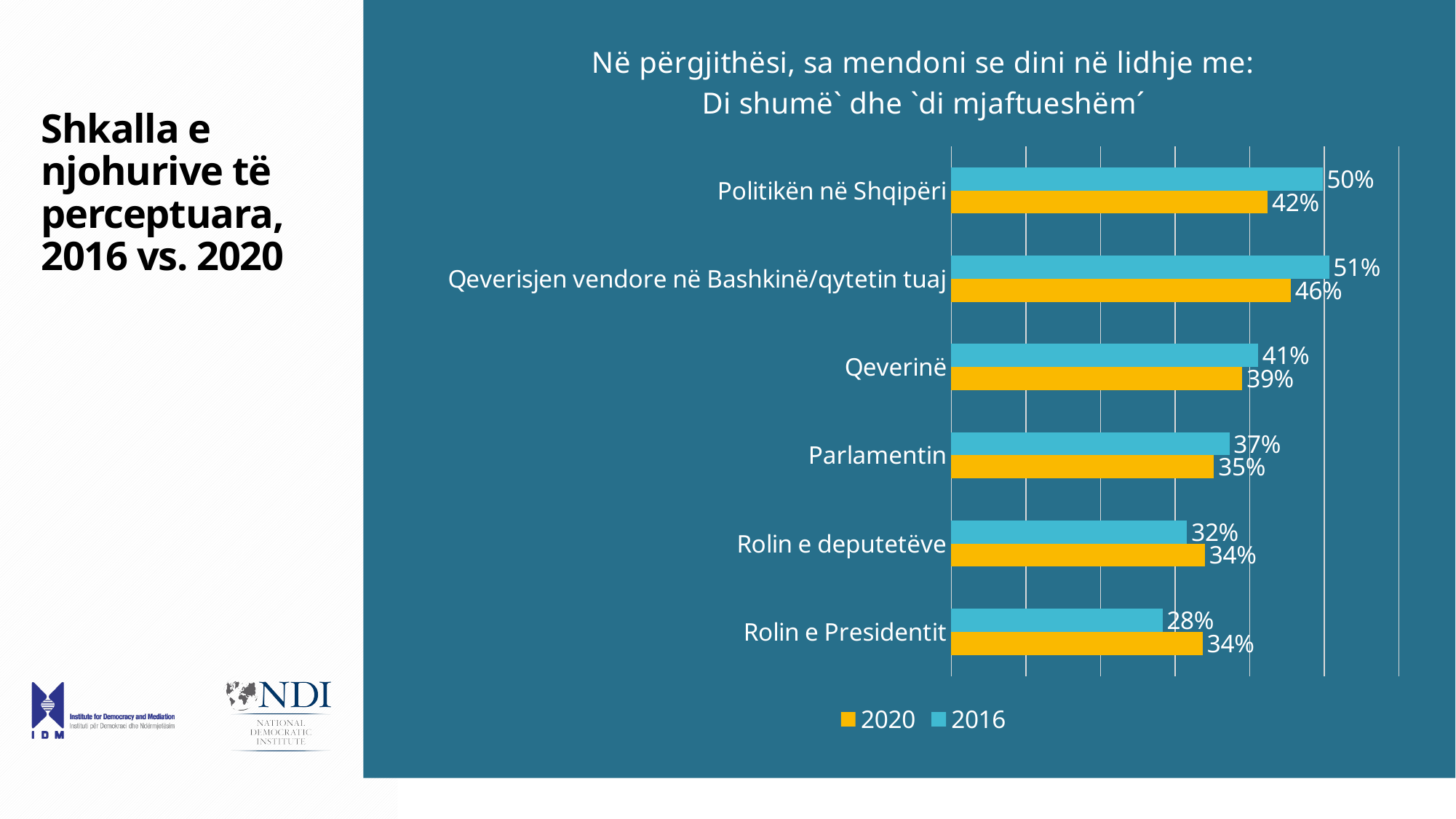
For Rolin e deputetëve, which is larger: the 2020 value or the 2016 value? 2020 What is the difference between the 2020 and 2016 values for Rolin e Presidentit? 6% Which colour represents the 2020 series? Yellow What is the difference between the 2016 and 2020 values for Politikën në Shqipëri? 8% Which category has the highest 2016 value? Qeverisjen vendore në Bashkinë/qytetin tuaj What is the 2020 value for Qeverisjen vendore në Bashkinë/qytetin tuaj? 46% How many categories are shown on the chart? 6 What kind of chart is shown on the slide? Bar chart What is the 2016 value for Politikën në Shqipëri? 50% What is the 2020 value for Rolin e Presidentit? 34% How many series does the legend list? 2 Which category has the lowest 2016 value? Rolin e Presidentit